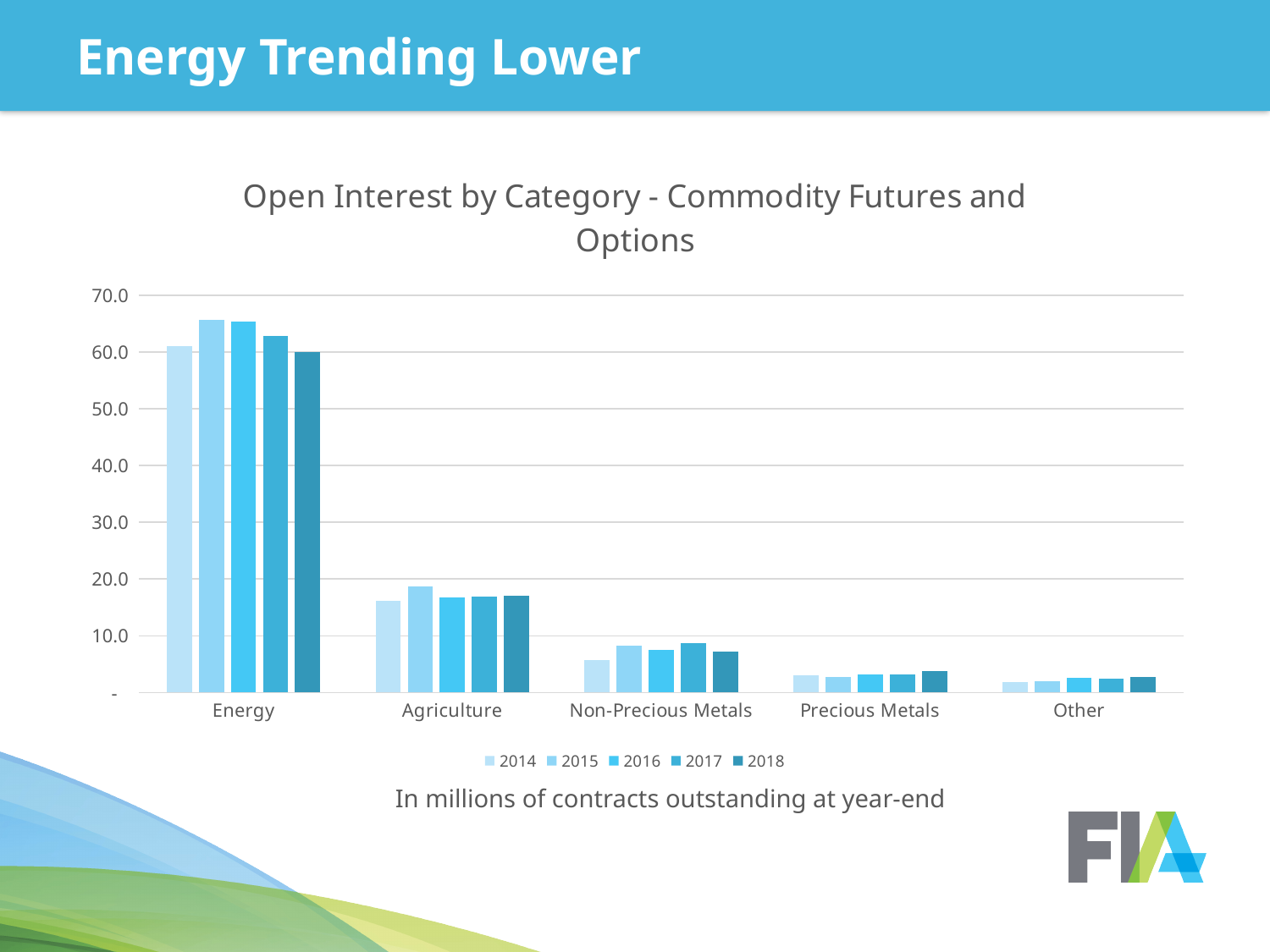
Is the value for Non-Precious Metals in 2017 greater or less than 10.0? less Which category has the lowest open interest in the chart? Other Is the value for Agriculture in 2015 greater or less than 20.0? less Which category has the highest open interest in the chart? Energy What kind of chart is shown on the slide? bar chart What is the title of the chart? Open Interest by Category - Commodity Futures and Options How many series does the legend list? 5 How many categories are shown on the x axis of the chart? 5 For Energy, which year has the larger value, 2015 or 2018? 2015 Is the value for Energy in 2018 greater or less than 50.0? greater In 2016, which category has the larger value, Agriculture or Non-Precious Metals? Agriculture